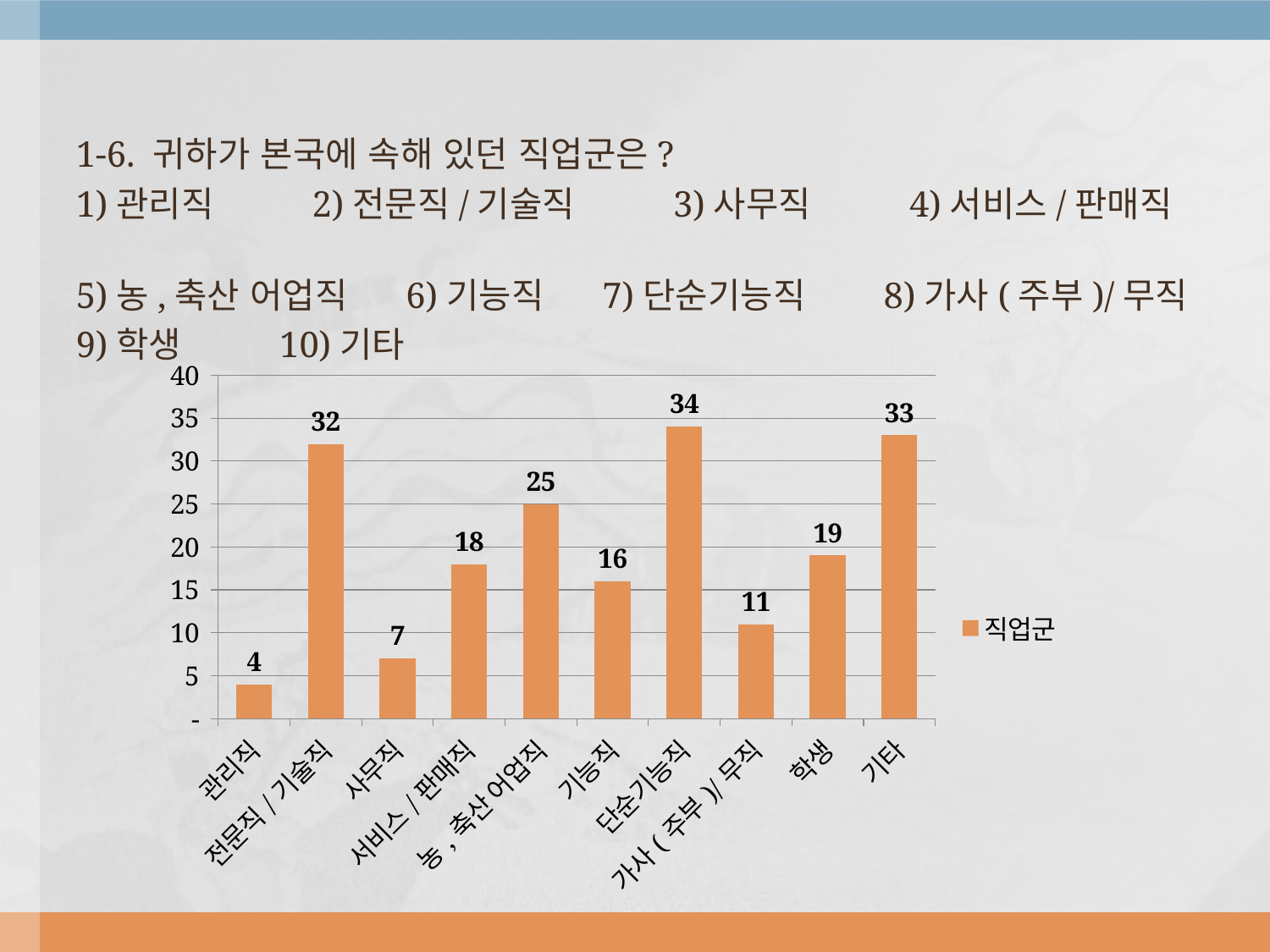
What kind of chart is shown? bar chart Which category has the lowest value? 관리직 Is the value for 농 , 축산 어업직 greater or less than 20? greater What is the value for 관리직? 4 How many categories are shown on the x axis? 10 How many series does the legend list? 1 Which category has the highest value? 단순기능직 What is the legend entry for the series? 직업군 What is the value for 단순기능직? 34 What is the value for 가사 ( 주부 )/ 무직? 11 Which is larger, the value for 서비스 / 판매직 or the value for 학생? 학생 What is the difference between the values for 전문직 / 기술직 and 사무직? 25